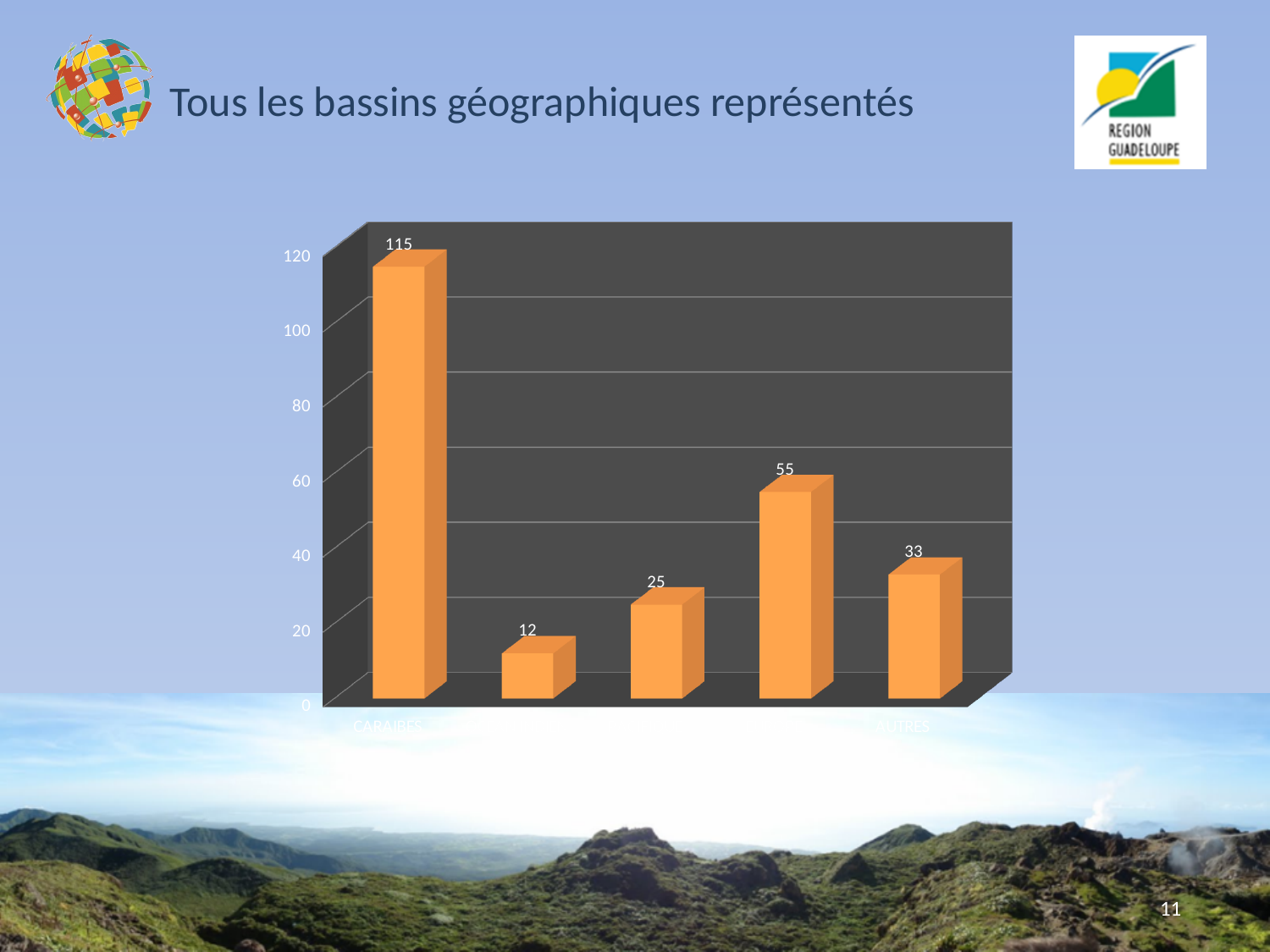
What is the value of the first (leftmost) bar, labelled CARAIBES? 115 Which is larger, the fourth bar (55) or the third bar (25)? the fourth bar (55) Which bar has the highest value? CARAIBES (the first bar, 115) Is the value for AUTRES greater or less than 40? less What is the title of the slide containing the chart? Tous les bassins géographiques représentés What is the lowest value plotted in the chart? 12 What kind of chart is shown on the slide? bar chart What is the difference between the value for CARAIBES and the value for AUTRES? 82 What is the value of the fourth bar from the left? 55 What is the value of the second bar from the left? 12 How many bars are plotted in the chart? 5 What is the value of the last (rightmost) bar, labelled AUTRES? 33